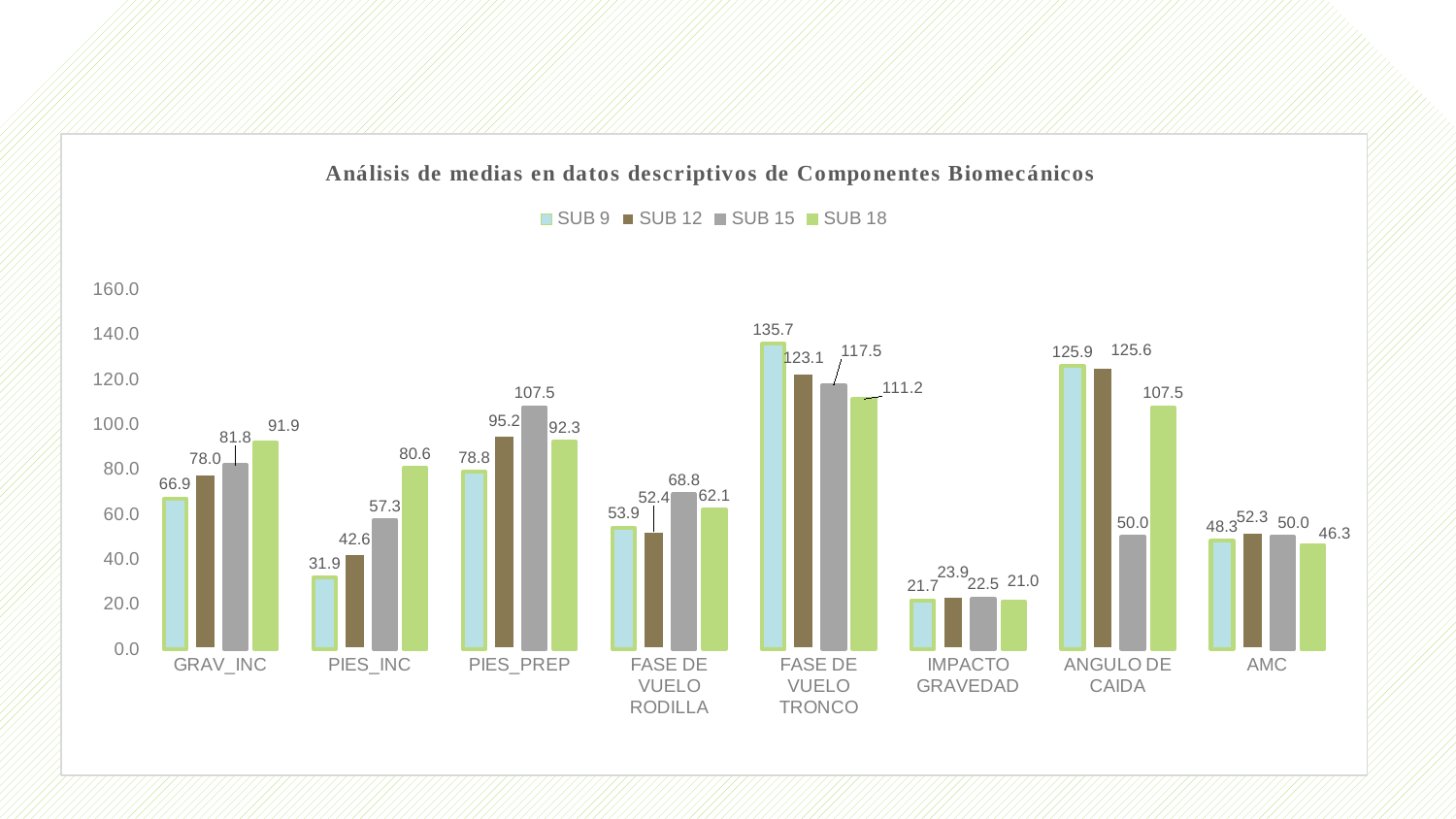
How many series does the legend list? 4 Which series has the lowest value for ANGULO DE CAIDA? SUB 15 Which series has the highest value for GRAV_INC? SUB 18 Which is larger for PIES_INC: the SUB 9 value or the SUB 15 value? SUB 15 What is the value of SUB 15 for PIES_PREP? 107.5 How many categories are shown on the x axis? 8 What is the value of SUB 18 for PIES_INC? 80.6 What is the title of the chart? Análisis de medias en datos descriptivos de Componentes Biomecánicos What type of chart is shown on the slide? bar chart Do the SUB 18 values rise or fall across the categories from FASE DE VUELO TRONCO to IMPACTO GRAVEDAD? fall What is the difference between the SUB 9 and SUB 18 values for FASE DE VUELO TRONCO? 24.5 What is the value of SUB 9 for FASE DE VUELO TRONCO? 135.7